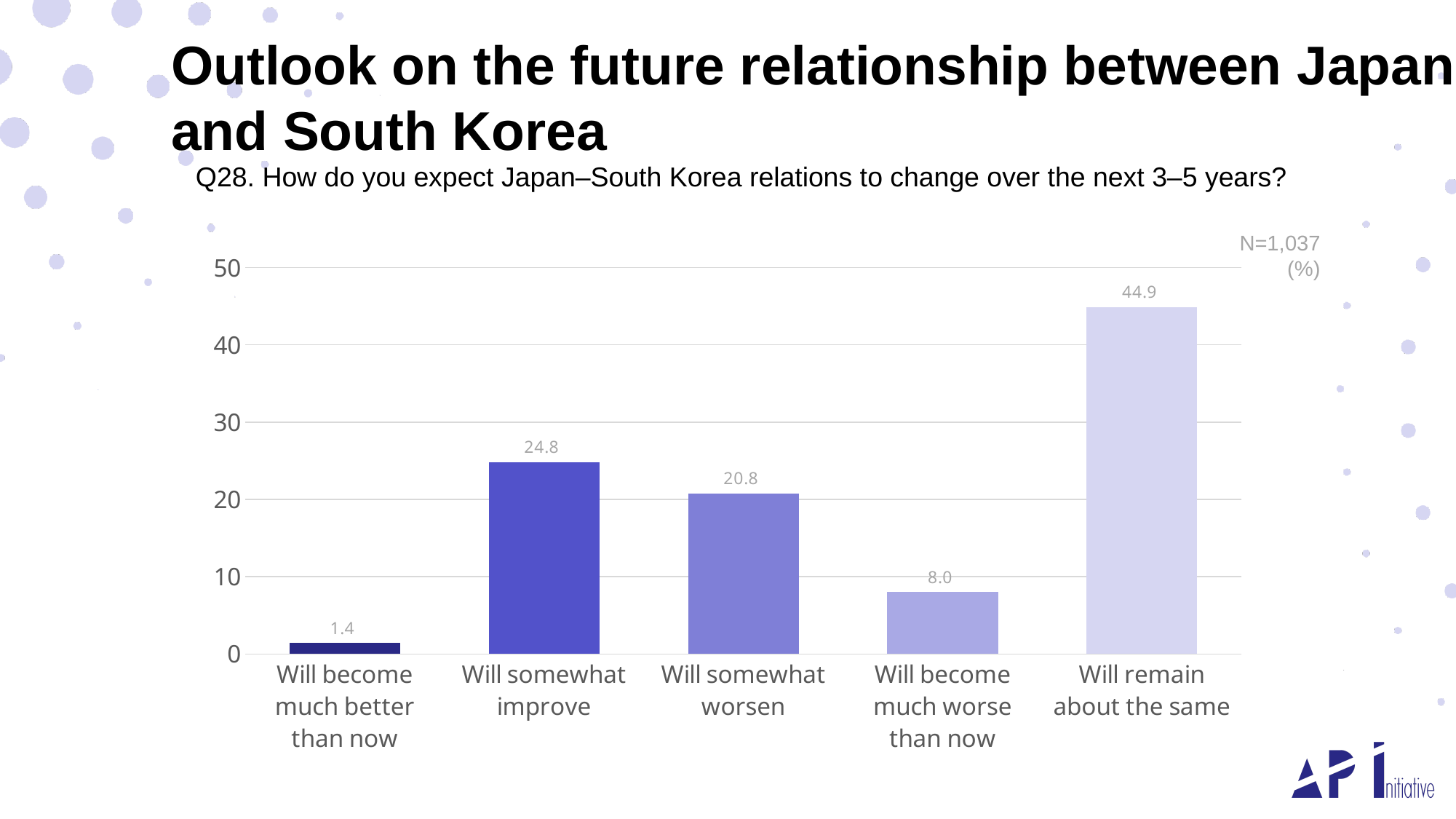
Which is larger: 'Will somewhat worsen' or 'Will become much worse than now'? Will somewhat worsen Is the value for 'Will remain about the same' greater or less than 40? greater What is the sample size (N) shown on the chart? N=1,037 What is the value for 'Will become much better than now'? 1.4 What is the value for 'Will become much worse than now'? 8.0 What is the difference between 'Will somewhat improve' and 'Will somewhat worsen'? 4.0 What is the value for 'Will somewhat improve'? 24.8 What kind of chart is shown on the slide? Bar chart What percentage of respondents expect Japan–South Korea relations will remain about the same? 44.9 Which response category has the highest value? Will remain about the same Which response category has the lowest value? Will become much better than now How many response categories are shown on the x axis? 5